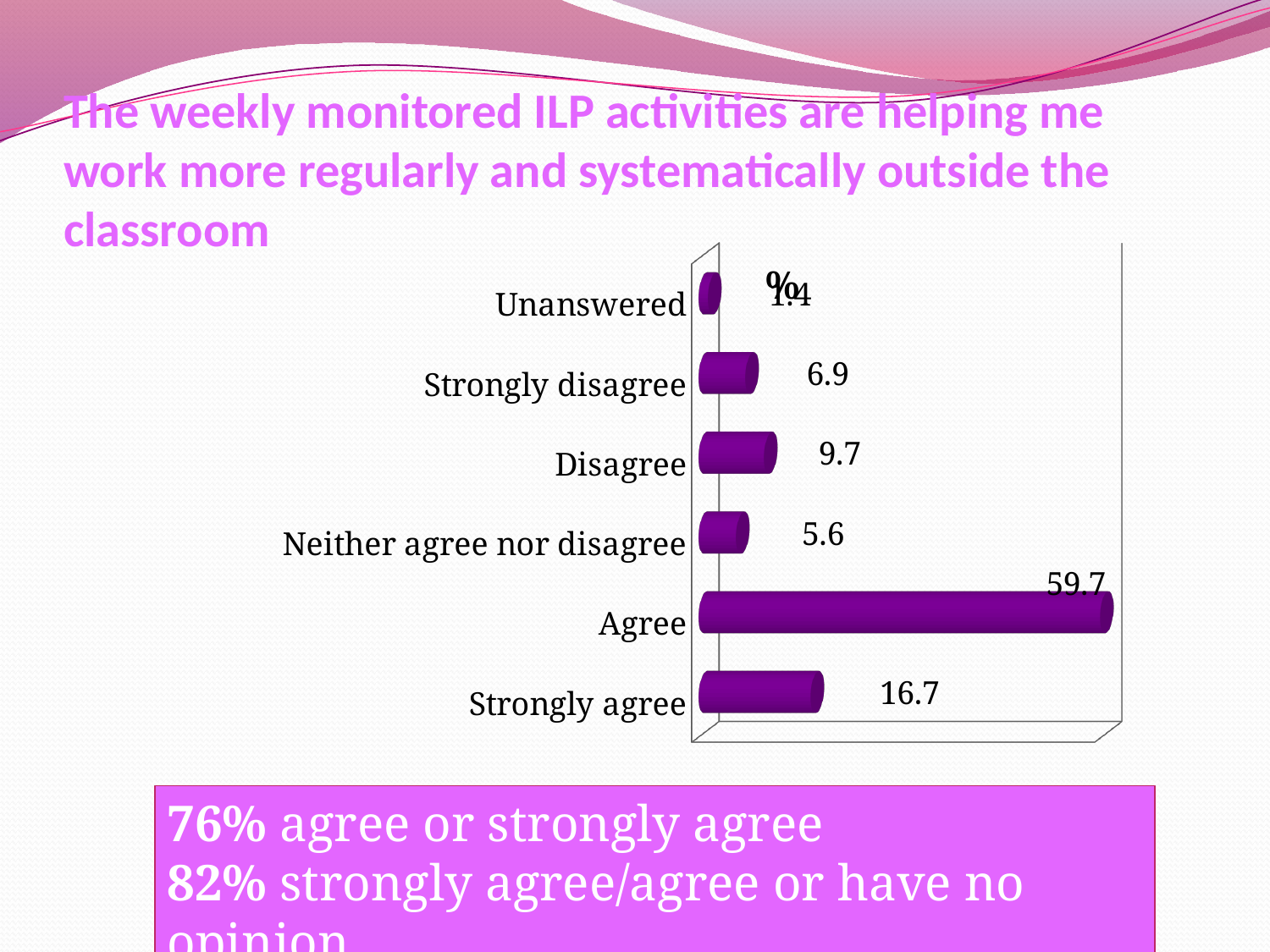
What is the difference between the values for Disagree and Strongly disagree? 2.8 Which category has the highest value? Agree How many categories are shown in the chart? 6 What kind of chart is shown on the slide? Bar chart What is the value for Disagree? 9.7 Which category has the lowest value? Unanswered What is the difference between the values for Agree and Strongly agree? 43.0 What is the value for Neither agree nor disagree? 5.6 What is the value for Agree? 59.7 What is the value for Strongly disagree? 6.9 Which is larger, the value for Disagree or the value for Neither agree nor disagree? Disagree What is the value for Strongly agree? 16.7